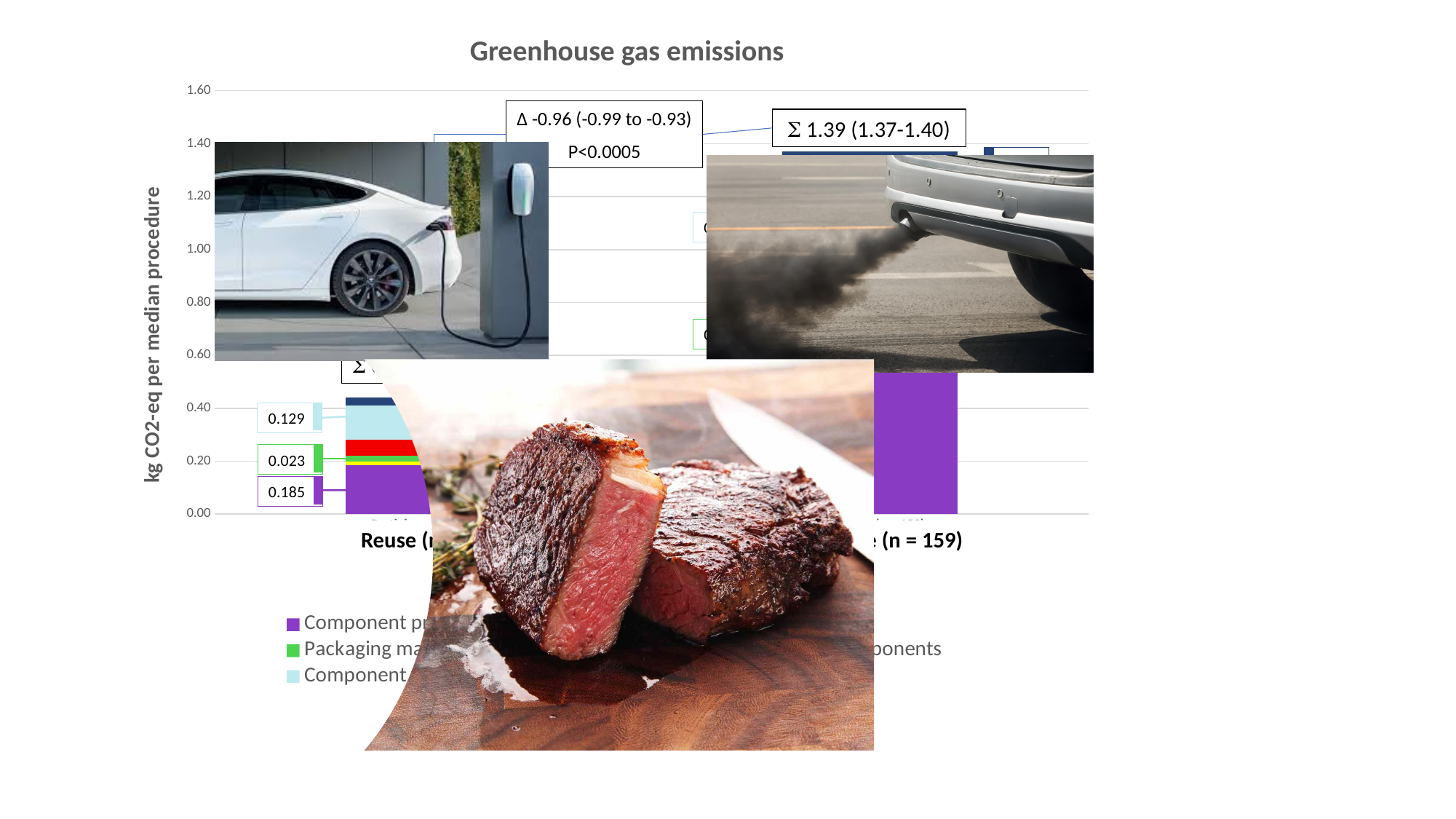
Is the total height of the Reuse bar greater or less than 0.60? less What is the value of the purple (bottom) segment of the Reuse bar? 0.185 Which bar is taller, the Reuse bar or the right-hand bar (n = 159)? The right-hand bar (n = 159) What difference (Δ) between the two bars is printed on the chart? -0.96 (-0.99 to -0.93) What kind of chart is shown on the slide? Stacked bar chart What is the value of the light blue segment of the Reuse bar? 0.129 What is the label of the vertical axis? kg CO2-eq per median procedure What total (Σ) is printed for the right-hand bar (n = 159)? 1.39 (1.37-1.40) How many bars (categories) are shown on the x axis? 2 What is the value of the green segment of the Reuse bar? 0.023 Is the total height of the right-hand bar (n = 159) greater or less than 1.20? greater What is the title of the chart? Greenhouse gas emissions